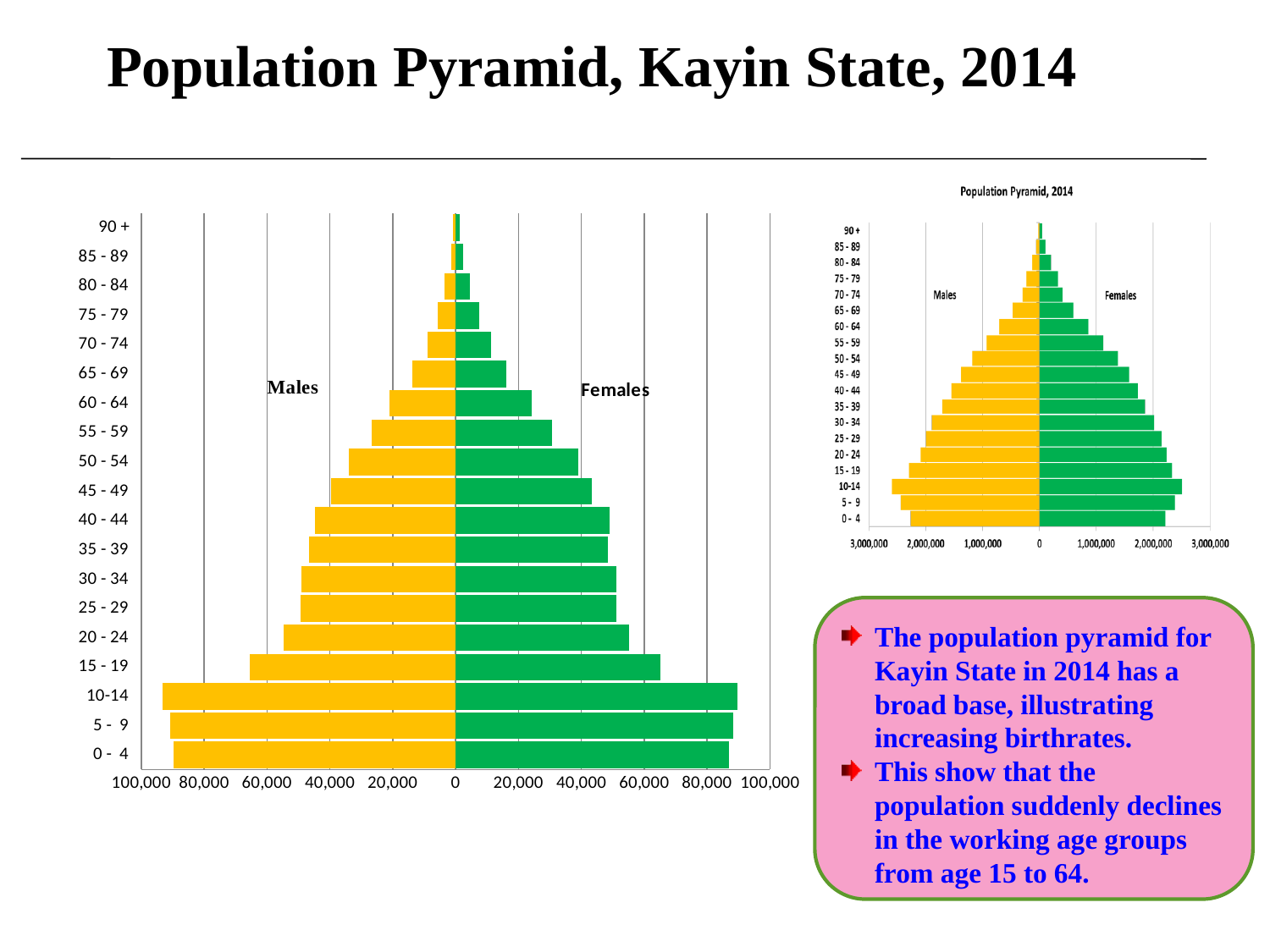
On the small chart on the right titled 'Population Pyramid, 2014', is the Males value for the 10-14 age group greater or less than 2,000,000? greater On the large left chart, which age group has the shortest Females bar? 90 + On the large left chart, how many age groups are shown on the vertical axis? 19 What is the title of the small chart on the right of the slide? Population Pyramid, 2014 What kind of chart is the large chart on the left of the slide? Bar chart (population pyramid) On the large left chart, is the Females value for the 20-24 age group greater or less than 60,000? less On the large left chart, which two groups are plotted as series? Males and Females On the large left chart, which age group has the longest Males bar? 10-14 On the large left chart, which is larger: the Females bar for 15-19 or the Females bar for 25-29? 15-19 On the large left chart, is the Males value for the 65-69 age group greater or less than 20,000? less On the large left chart, do the Males bars get longer or shorter as the age groups go from 15-19 up to 90 +? shorter